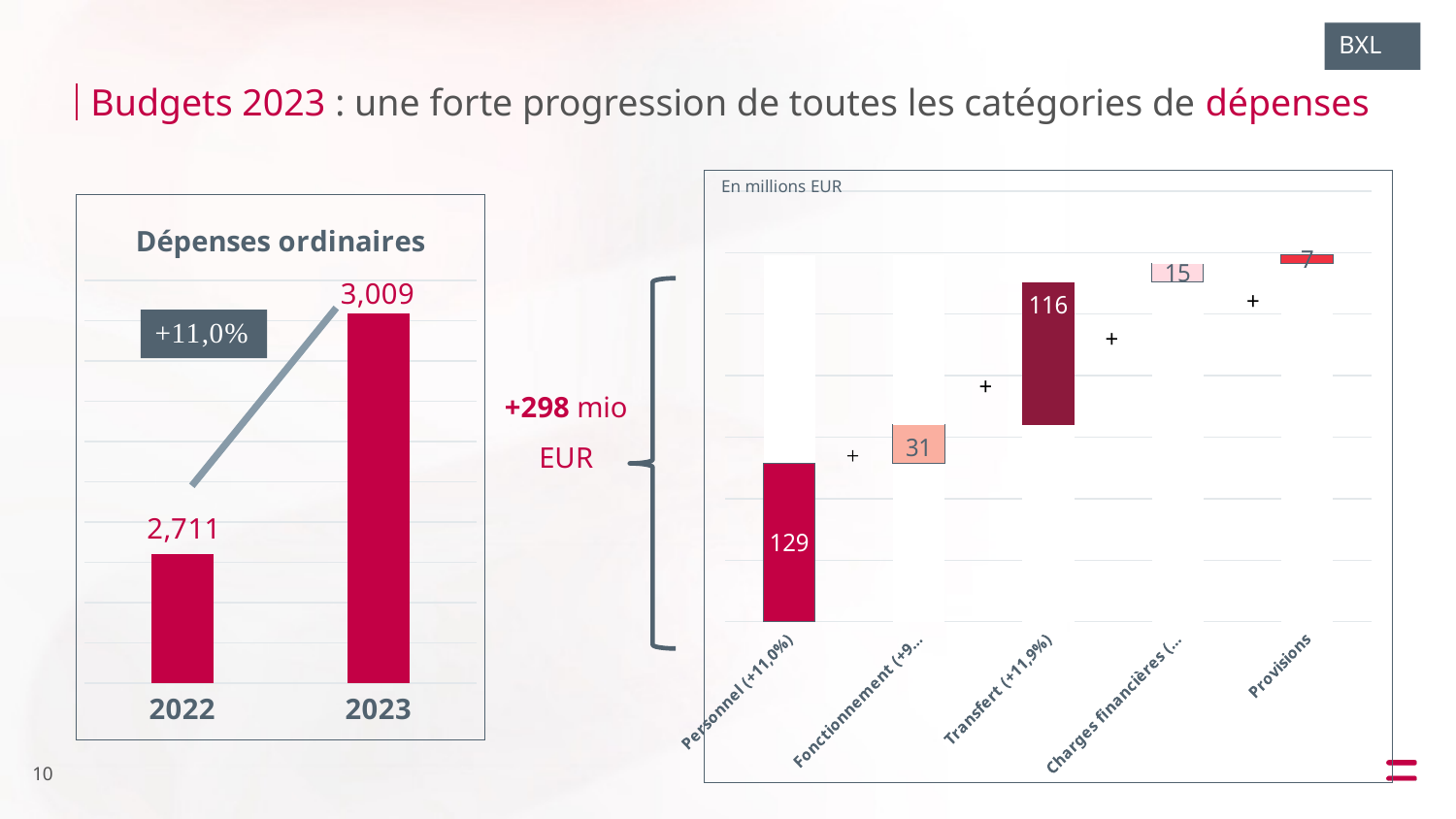
In the 'Dépenses ordinaires' chart, what is the value for 2022? 2,711 In the 'Dépenses ordinaires' chart, what percentage change is shown between 2022 and 2023? +11,0% In the waterfall chart on the right ('En millions EUR'), what is the value for Fonctionnement? 31 In the waterfall chart on the right ('En millions EUR'), what is the value for Personnel? 129 In the 'Dépenses ordinaires' chart, what is the difference between the 2023 and 2022 values? 298 What kind of chart is the 'Dépenses ordinaires' chart? bar chart In the waterfall chart on the right ('En millions EUR'), which category has the highest value? Personnel In the 'Dépenses ordinaires' chart, what is the value for 2023? 3,009 In the waterfall chart on the right ('En millions EUR'), what is the value for Transfert? 116 How many categories are shown in the waterfall chart on the right ('En millions EUR')? 5 In the waterfall chart on the right ('En millions EUR'), which category has the lowest value? Provisions In the 'Dépenses ordinaires' chart, which year has the higher value? 2023